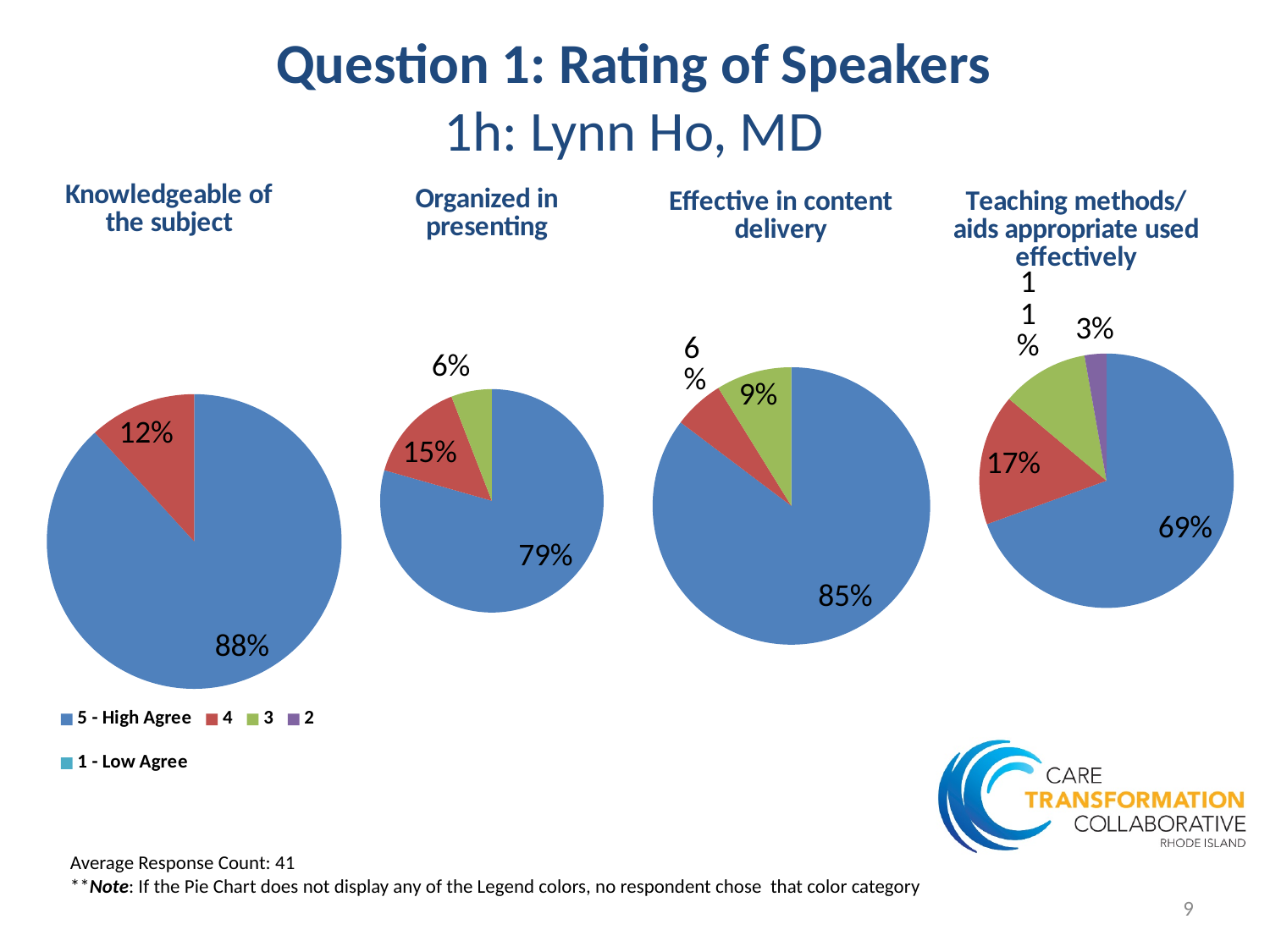
In the 'Knowledgeable of the subject' pie chart, what share of respondents chose '4'? 12% In the 'Organized in presenting' pie chart, what is the difference between the '5 - High Agree' share and the '4' share? 64% Which is larger in the 'Effective in content delivery' pie chart: the share for '3' or the share for '4'? 3 In the 'Effective in content delivery' pie chart, what share of respondents chose '5 - High Agree'? 85% In the 'Teaching methods/aids appropriate used effectively' pie chart, which rating has the largest slice? 5 - High Agree How many slices does the 'Teaching methods/aids appropriate used effectively' pie chart have? 4 In the 'Organized in presenting' pie chart, what share of respondents chose '3'? 6% In the 'Effective in content delivery' pie chart, which rating has the smallest slice? 4 In the 'Teaching methods/aids appropriate used effectively' pie chart, what share of respondents chose '2'? 3% How many entries does the legend list? 5 What type of chart is used for 'Organized in presenting'? Pie chart In the 'Knowledgeable of the subject' pie chart, what share of respondents chose '5 - High Agree'? 88%